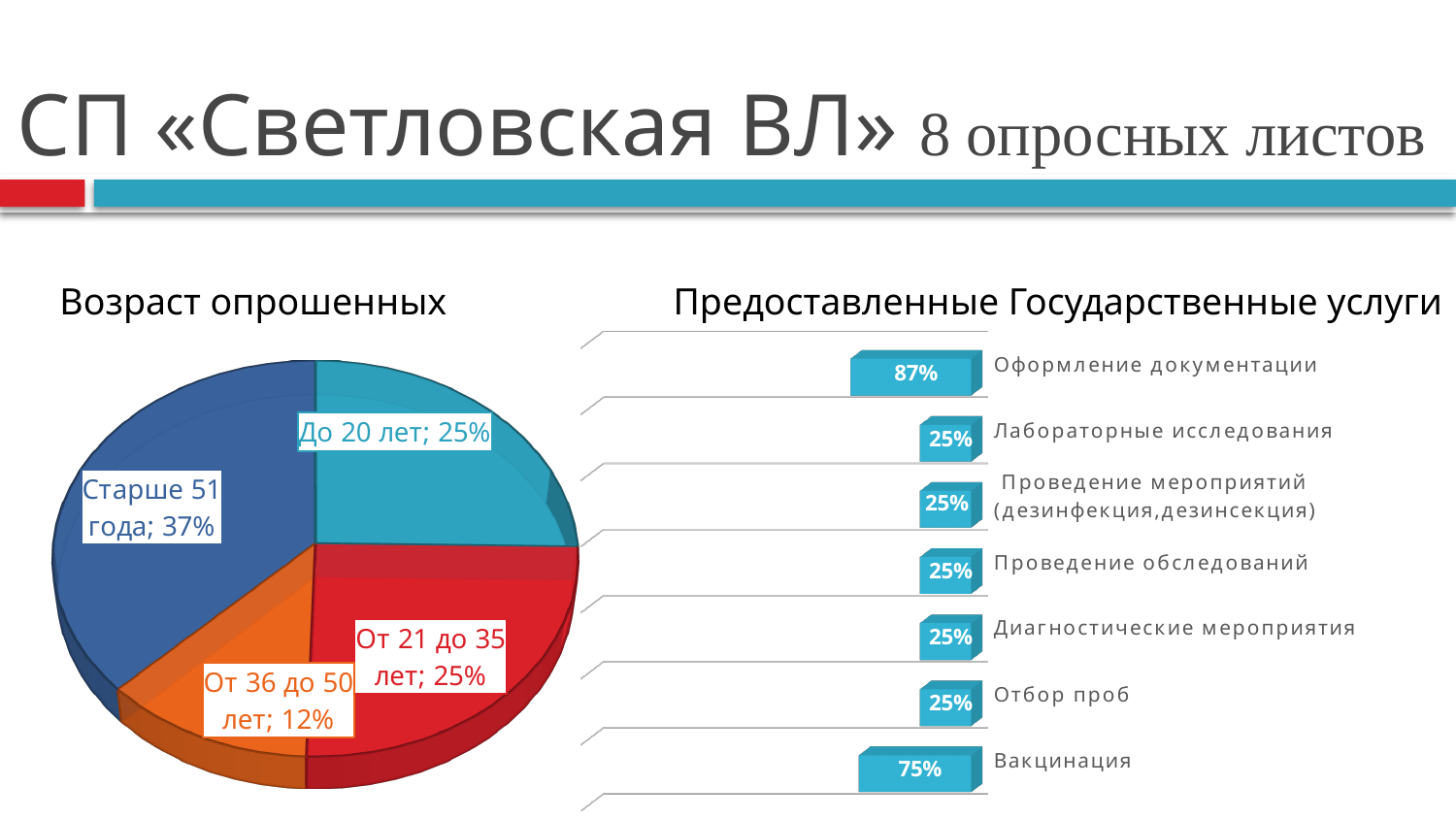
In the chart 'Возраст опрошенных', what share of respondents are 'Старше 51 года'? 37% In the chart 'Предоставленные Государственные услуги', what is the value for 'Оформление документации'? 87% In the chart 'Возраст опрошенных', which age group has the largest share? Старше 51 года In the chart 'Предоставленные Государственные услуги', which service has the highest value? Оформление документации In the chart 'Возраст опрошенных', what is the difference between the shares for 'Старше 51 года' and 'От 36 до 50 лет'? 25% What kind of chart is 'Возраст опрошенных'? Pie chart In the chart 'Возраст опрошенных', which age group has the smallest share? От 36 до 50 лет How many services are listed in the chart 'Предоставленные Государственные услуги'? 7 In the chart 'Предоставленные Государственные услуги', what is the value for 'Вакцинация'? 75% How many age groups are shown in the chart 'Возраст опрошенных'? 4 In the chart 'Предоставленные Государственные услуги', what is the difference between 'Оформление документации' and 'Вакцинация'? 12% In the chart 'Возраст опрошенных', what share of respondents are 'От 36 до 50 лет'? 12%